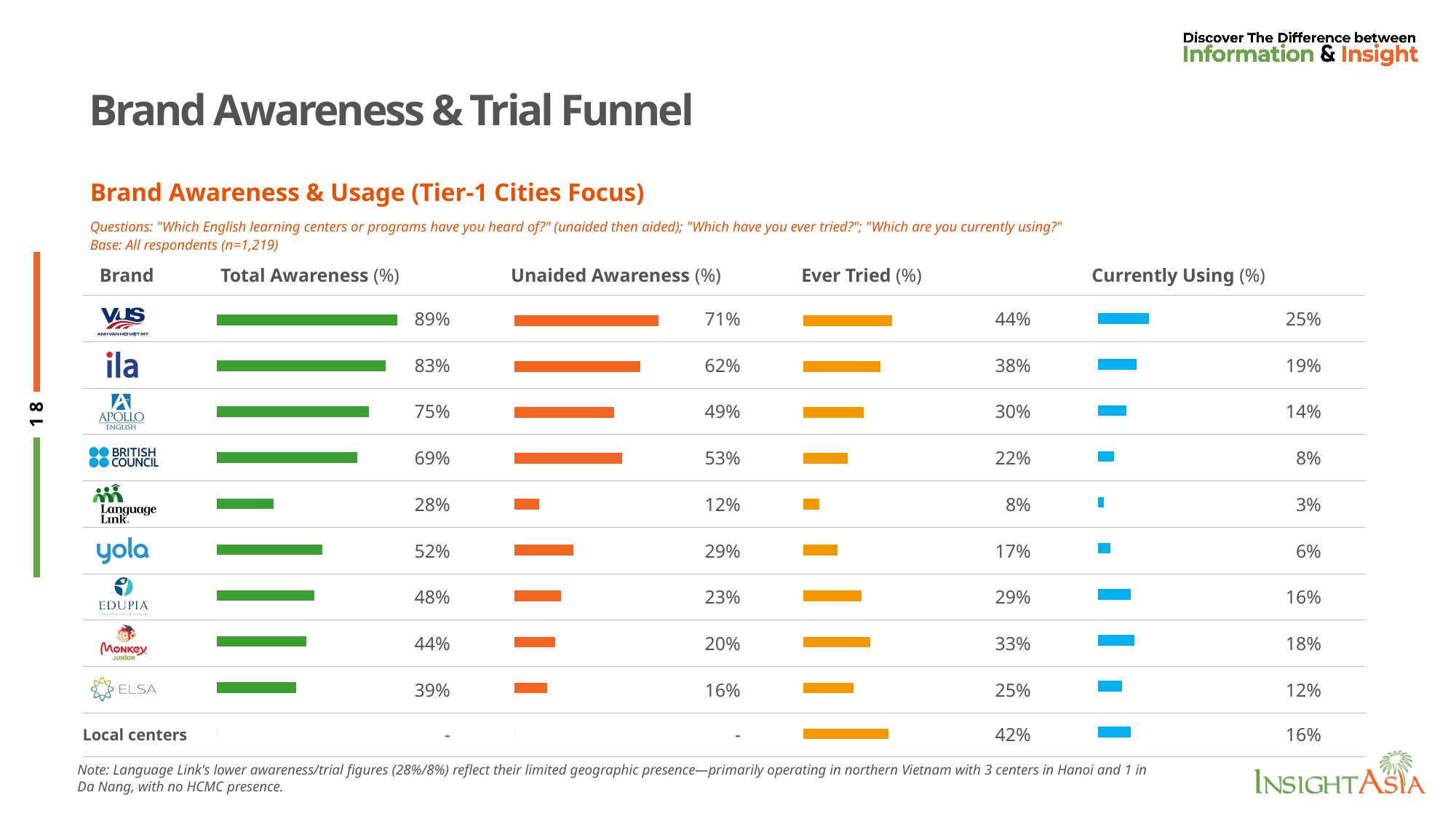
What is the Total Awareness (%) value for VUS? 89% Which brand has the lowest Currently Using (%)? Language Link How many brands (rows) are listed in the Brand Awareness & Usage table? 10 What type of chart is used to show the values in the Brand Awareness & Usage table? Bar chart What is the Unaided Awareness (%) value for British Council? 53% What is the difference between the Unaided Awareness (%) and Ever Tried (%) for VUS? 27% What is the Currently Using (%) value for Monkey Junior? 18% What is the Ever Tried (%) value for Local centers? 42% Which has a higher Ever Tried (%): Edupia or Yola? Edupia What colour are the bars in the Currently Using (%) column? Blue Which brand has the highest Total Awareness (%)? VUS What is the difference between the Total Awareness (%) of ILA and Apollo English? 8%